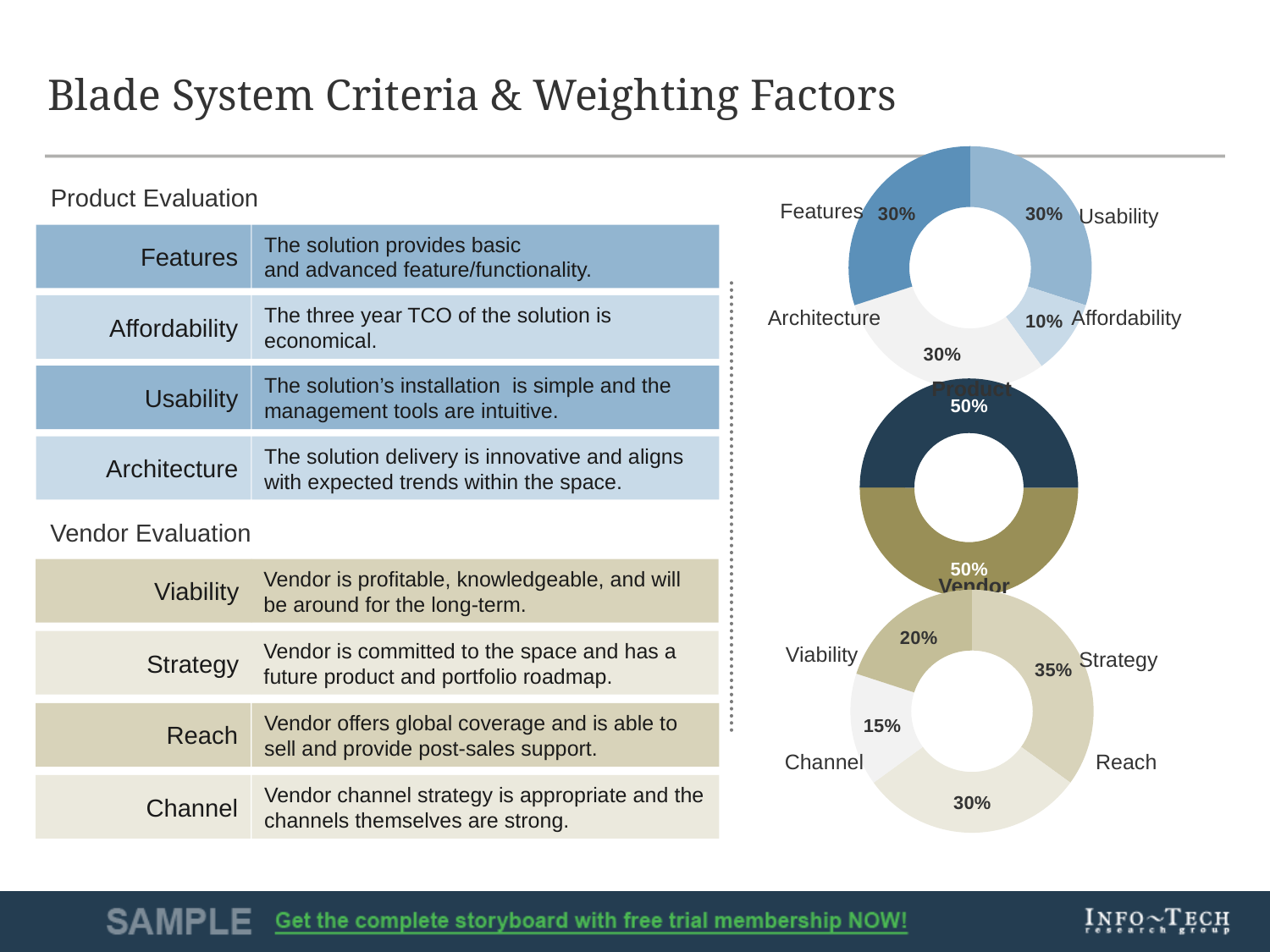
In the bottom donut chart, what is the difference between the weightings for Strategy and Viability? 15% In the top donut chart, which category has the lowest weighting? Affordability In the bottom donut chart, which category has the highest weighting? Strategy In the bottom donut chart, what is the weighting for Strategy? 35% In the bottom donut chart, what is the weighting for Channel? 15% In the bottom donut chart, which category has the lowest weighting? Channel How many segments does the middle donut chart have? 2 In the top donut chart, what is the weighting for Architecture? 30% In the middle donut chart, what is the weighting for Vendor? 50% In the top donut chart, what is the weighting for Affordability? 10% What type of chart is used to show the weighting factors on this slide? Donut (pie) chart How many categories are shown in the top donut chart? 4